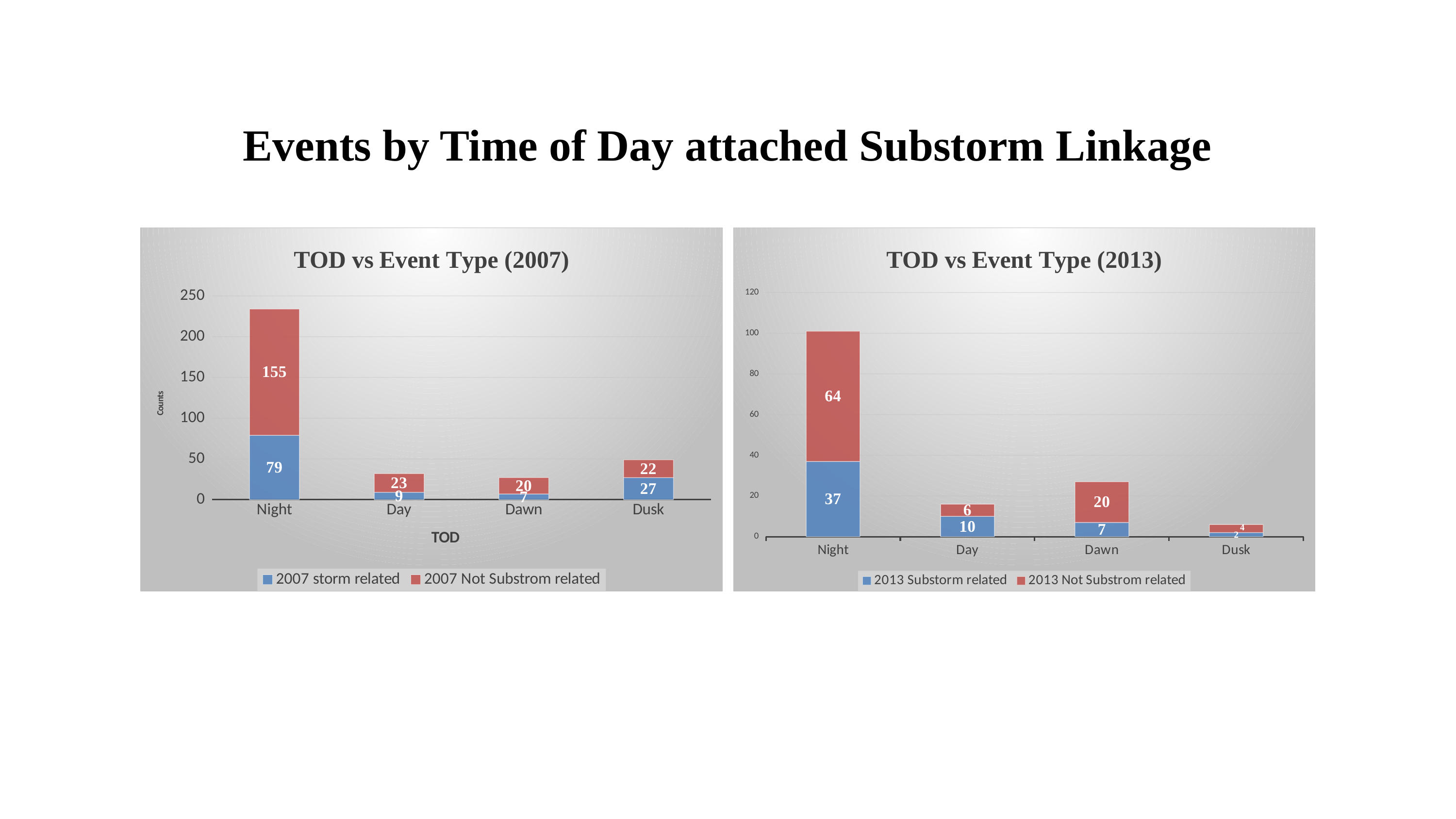
In the 'TOD vs Event Type (2013)' chart, what is the total of the stacked bar for Night? 101 In the 'TOD vs Event Type (2007)' chart, which time of day has the highest 2007 storm related value? Night In the 'TOD vs Event Type (2007)' chart, what is the difference between the 2007 Not Substrom related values for Day and Dawn? 3 In the 'TOD vs Event Type (2007)' chart, what is the value for 2007 storm related at Night? 79 In the 'TOD vs Event Type (2007)' chart, what is the value for 2007 Not Substrom related at Night? 155 In the 'TOD vs Event Type (2013)' chart, what is the value for 2013 Substorm related at Night? 37 In the 'TOD vs Event Type (2013)' chart, which time of day has the lowest 2013 Substorm related value? Dusk How many series does the legend of the 'TOD vs Event Type (2007)' chart list? 2 In the 'TOD vs Event Type (2013)' chart, is the 2013 Substorm related value for Day larger or the 2013 Not Substrom related value for Day? 2013 Substorm related In the 'TOD vs Event Type (2007)' chart, what is the total of the stacked bar for Dusk? 49 What kind of chart is 'TOD vs Event Type (2013)'? Stacked bar chart In the 'TOD vs Event Type (2013)' chart, what is the value for 2013 Not Substrom related at Dawn? 20